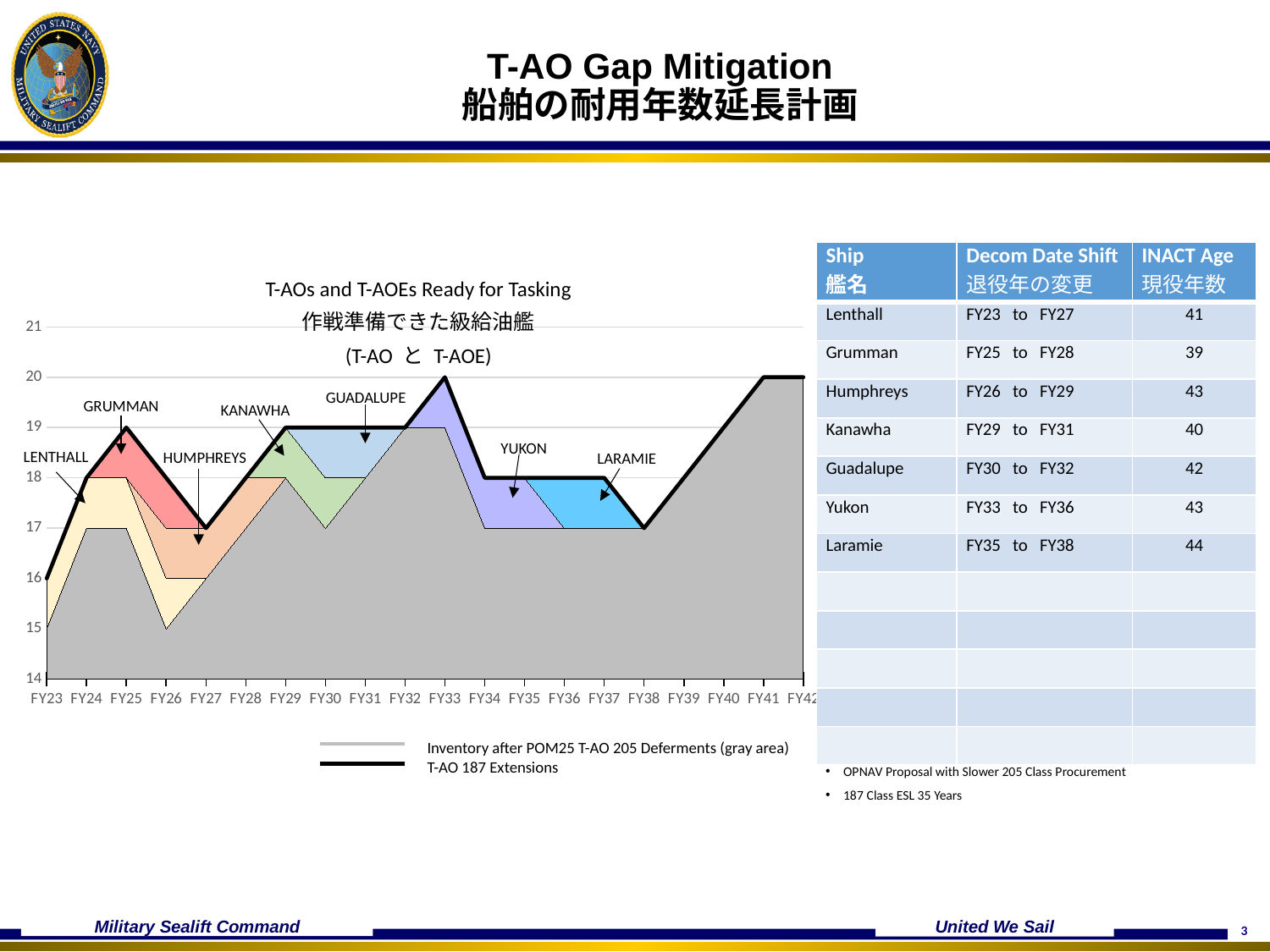
What is the difference between the T-AO 187 Extensions line at FY33 and at FY38? 3 Which is larger for the T-AO 187 Extensions line: the value at FY27 or the value at FY29? FY29 What is the title of the chart on the slide? T-AOs and T-AOEs Ready for Tasking How many fiscal years are shown along the x axis of the chart? 20 How many entries does the chart legend list? 2 Is the value of the T-AO 187 Extensions line at FY25 greater or less than 18? greater What does the black line in the chart represent, according to the legend? T-AO 187 Extensions Is the gray area (Inventory after POM25 T-AO 205 Deferments) at FY26 greater or less than 16? less What is the value of the T-AO 187 Extensions line at FY38? 17 What is the value of the T-AO 187 Extensions line at FY33? 20 What is the value of the T-AO 187 Extensions line at FY23? 16 Does the T-AO 187 Extensions line rise or fall from FY38 to FY41? rise